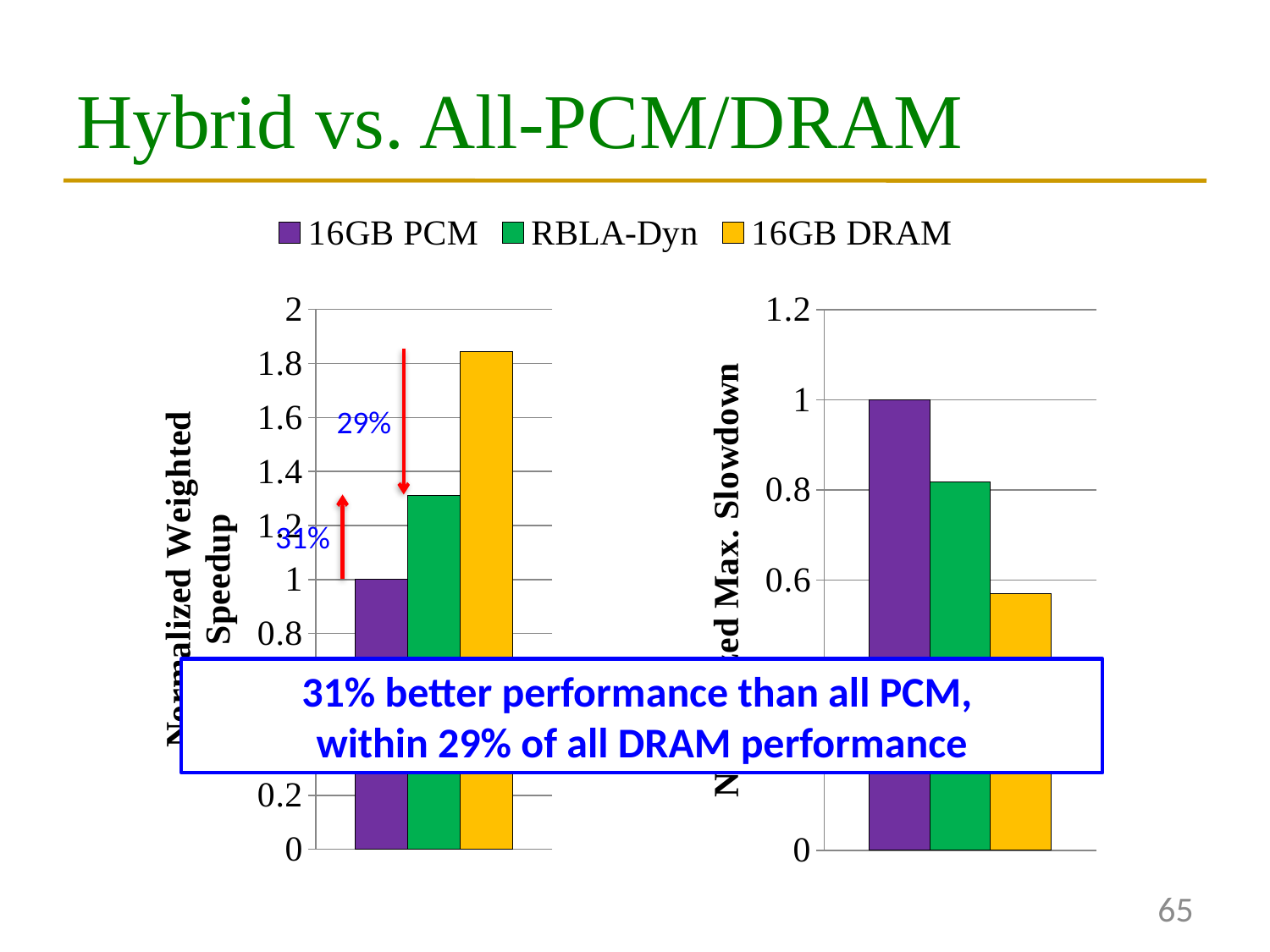
What kind of chart is the left chart (Normalized Weighted Speedup)? bar chart In the left chart (Normalized Weighted Speedup), is the value for 16GB DRAM greater or less than 1.6? greater In the left chart (Normalized Weighted Speedup), which series has the highest bar? 16GB DRAM How many series does the legend list? 3 In the right chart, what is the value for 16GB PCM? 1 In the right chart, is the value for 16GB DRAM greater or less than 0.8? less In the right chart, which series has the lowest bar? 16GB DRAM In the left chart (Normalized Weighted Speedup), which series has the lowest bar? 16GB PCM In the left chart (Normalized Weighted Speedup), what is the value for 16GB PCM? 1 In the right chart, which series has the highest bar? 16GB PCM In the left chart (Normalized Weighted Speedup), which is larger, the bar for RBLA-Dyn or the bar for 16GB DRAM? 16GB DRAM In the left chart (Normalized Weighted Speedup), is the value for RBLA-Dyn greater or less than 1.2? greater